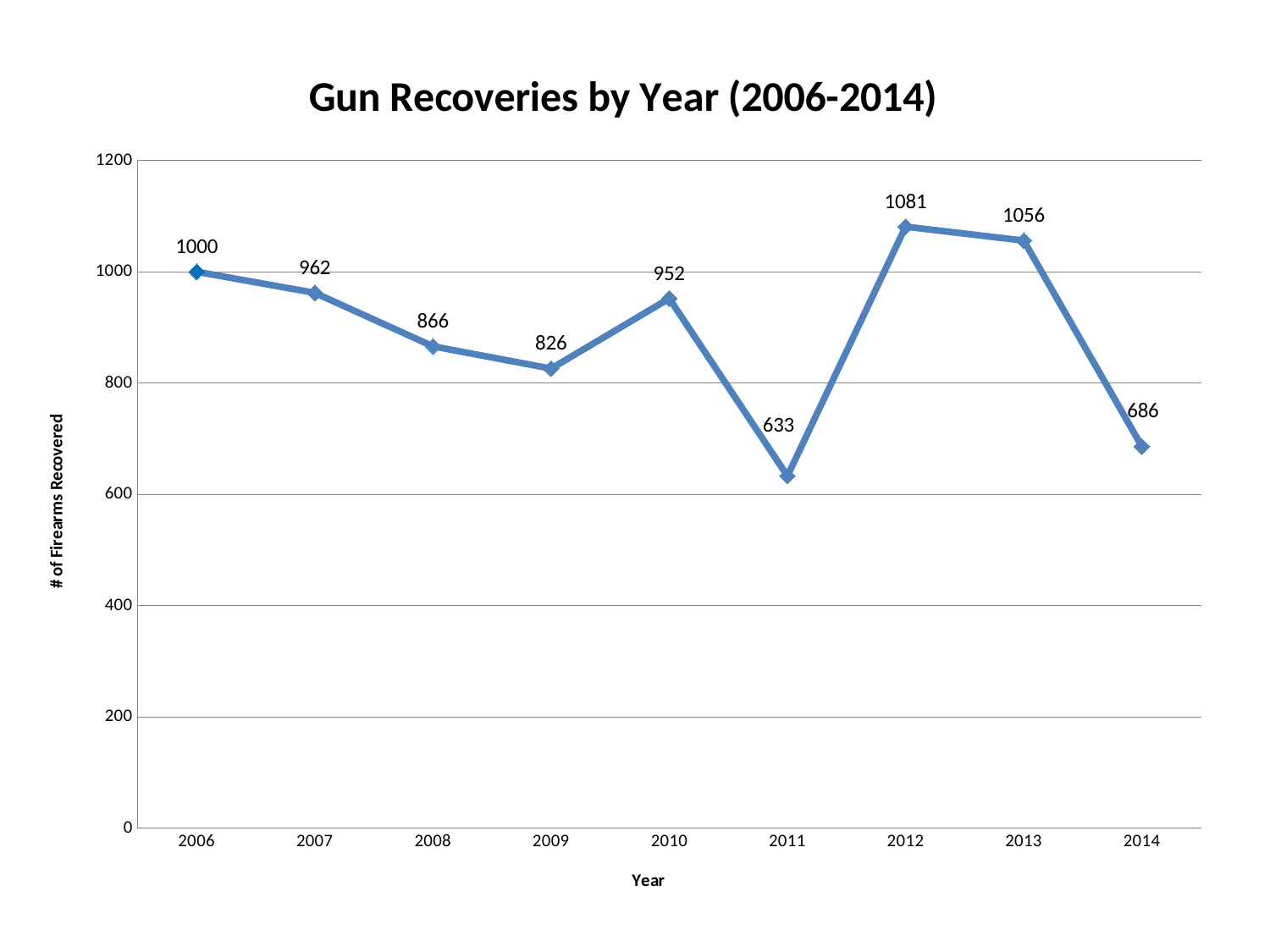
Which year has the lowest number of firearms recovered? 2011 What is the number of firearms recovered in 2009? 826 What kind of chart is shown on the slide? Line chart What is the title of the chart? Gun Recoveries by Year (2006-2014) How many years are plotted on the chart? 9 What is the number of firearms recovered in 2012? 1081 Is the value for 2014 greater or less than 800? less What is the difference between the number of firearms recovered in 2012 and in 2011? 448 Do the values rise or fall from 2006 to 2009? fall Which year has the highest number of firearms recovered? 2012 What is the difference between the number of firearms recovered in 2006 and in 2014? 314 Which year had more firearms recovered, 2010 or 2013? 2013